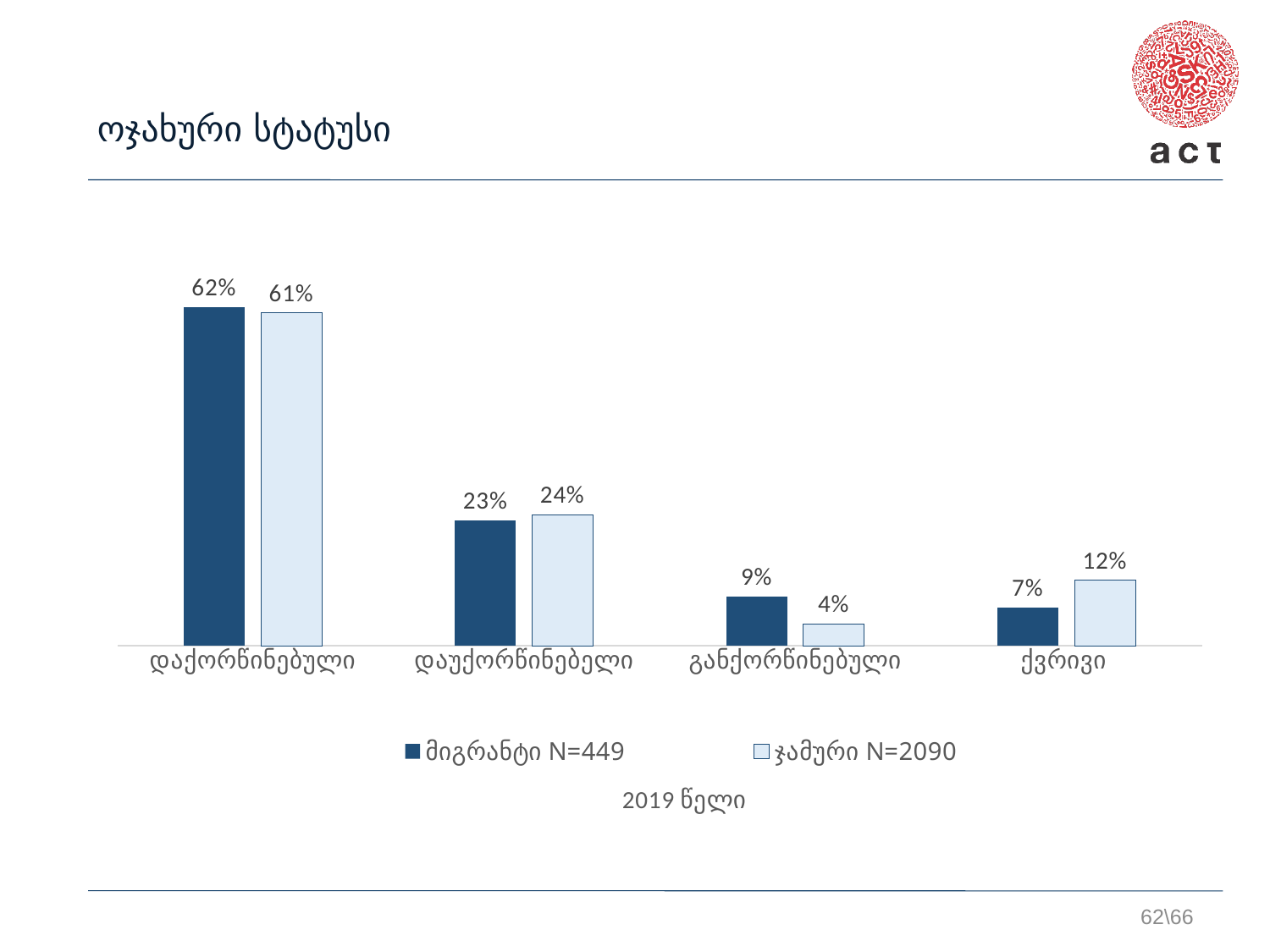
What kind of chart is shown on the slide? bar chart How many categories are shown on the x axis? 4 What is the difference between the მიგრანტი N=449 and ჯამური N=2090 values in the განქორწინებული category? 5% What is the value for მიგრანტი N=449 in the დაუქორწინებელი category? 23% What is the value for მიგრანტი N=449 in the დაქორწინებული category? 62% What is the title of the slide? ოჯახური სტატუსი Which category has the highest value for the ჯამური N=2090 series? დაქორწინებული What is the value for ჯამური N=2090 in the ქვრივი category? 12% How many series does the legend list? 2 In the ქვრივი category, which series has the larger value, მიგრანტი N=449 or ჯამური N=2090? ჯამური N=2090 Which category has the lowest value for the მიგრანტი N=449 series? ქვრივი What is the value for ჯამური N=2090 in the განქორწინებული category? 4%